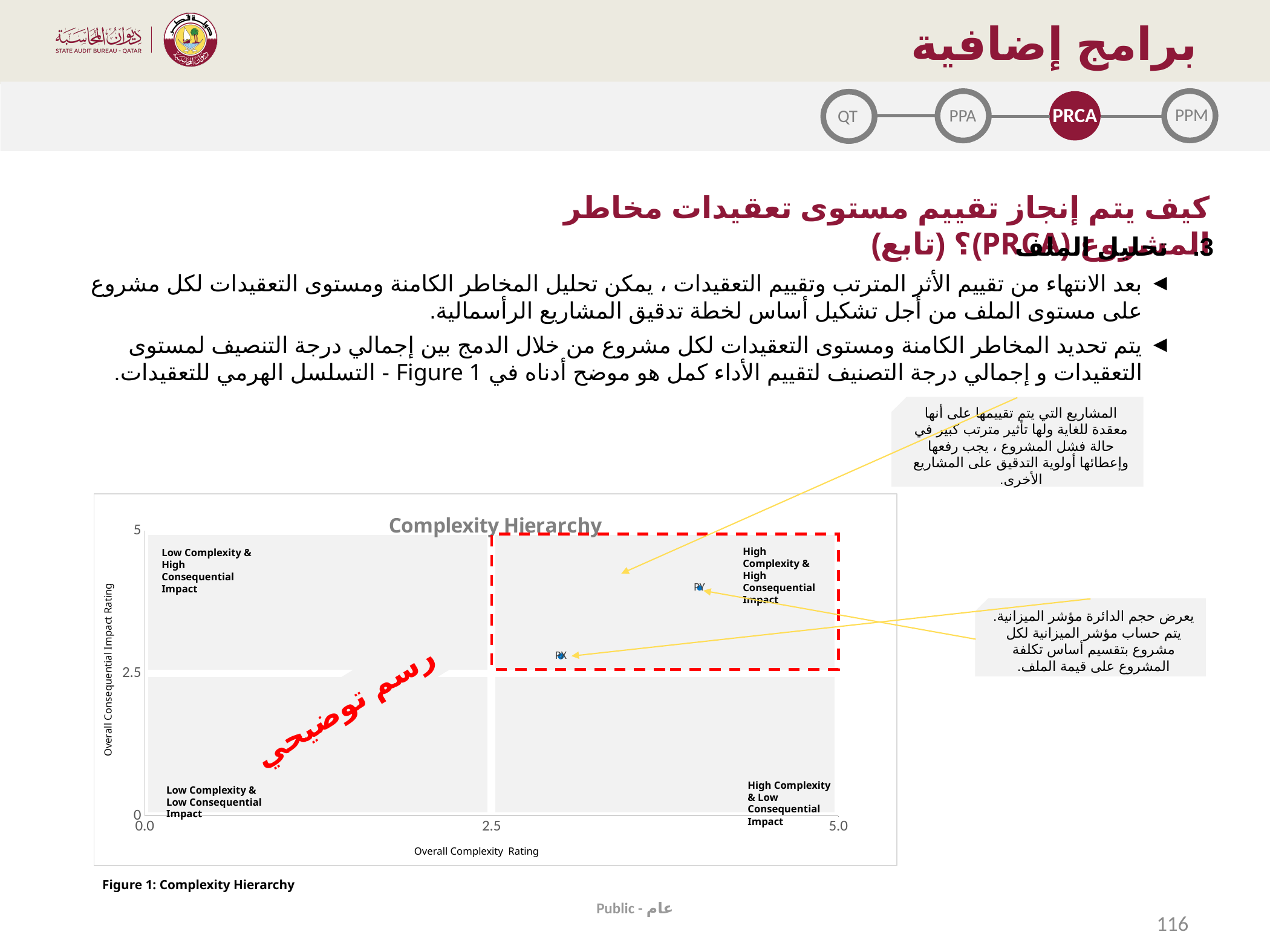
Which quadrant of the chart is outlined with a red dashed box? High Complexity & High Consequential Impact How many data points are plotted on the chart? 2 What is the highest value shown on the y axis of the chart? 5 Which of the two plotted points, PX or PY, has the higher Overall Consequential Impact Rating? PY Is the Overall Consequential Impact Rating of the point labelled PY greater or less than 2.5? greater What is the title of the chart? Complexity Hierarchy Is the Overall Complexity Rating of the point labelled PY greater or less than 2.5? greater What is the highest value shown on the x axis of the chart? 5.0 What kind of chart is shown on the slide? Scatter chart Is the Overall Complexity Rating of the point labelled PX greater or less than 2.5? greater Which of the two plotted points, PX or PY, has the higher Overall Complexity Rating? PY What is the label of the x axis of the chart? Overall Complexity Rating